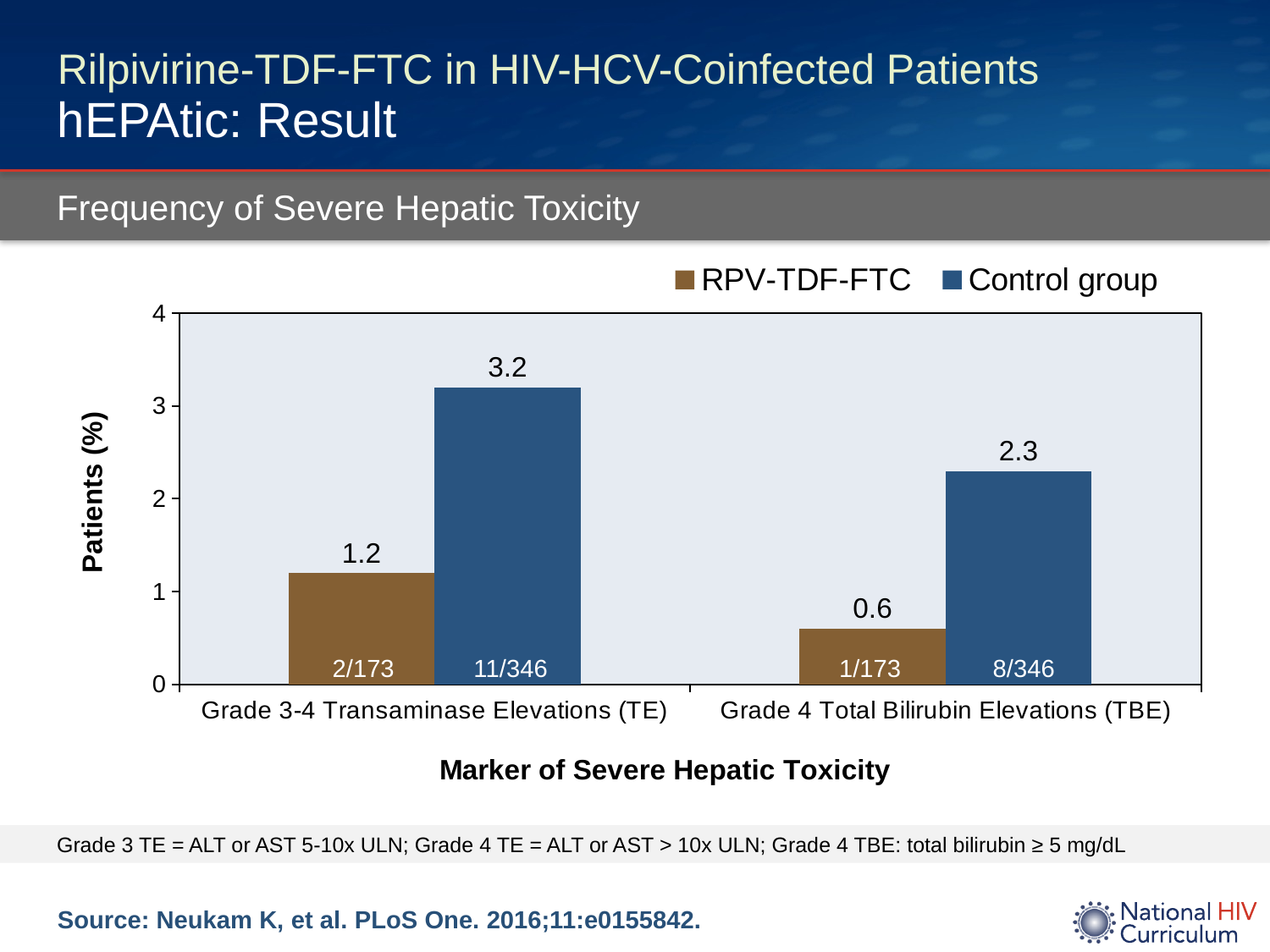
Which bar has the highest value on the chart? Control group, Grade 3-4 Transaminase Elevations (TE) What percentage of patients in the Control group had Grade 3-4 Transaminase Elevations (TE)? 3.2 What fraction of patients is shown inside the Control group bar for Grade 3-4 Transaminase Elevations (TE)? 11/346 What type of chart is shown on the slide? Bar chart What is the difference in percentage points between the Control group and RPV-TDF-FTC for Grade 3-4 Transaminase Elevations (TE)? 2.0 For Grade 4 Total Bilirubin Elevations (TBE), which group has the larger percentage, RPV-TDF-FTC or Control group? Control group Which bar has the lowest value on the chart? RPV-TDF-FTC, Grade 4 Total Bilirubin Elevations (TBE) What percentage of patients in the RPV-TDF-FTC group had Grade 3-4 Transaminase Elevations (TE)? 1.2 What fraction of patients is shown inside the RPV-TDF-FTC bar for Grade 4 Total Bilirubin Elevations (TBE)? 1/173 What percentage of patients in the Control group had Grade 4 Total Bilirubin Elevations (TBE)? 2.3 What percentage of patients in the RPV-TDF-FTC group had Grade 4 Total Bilirubin Elevations (TBE)? 0.6 How many series does the legend list? 2